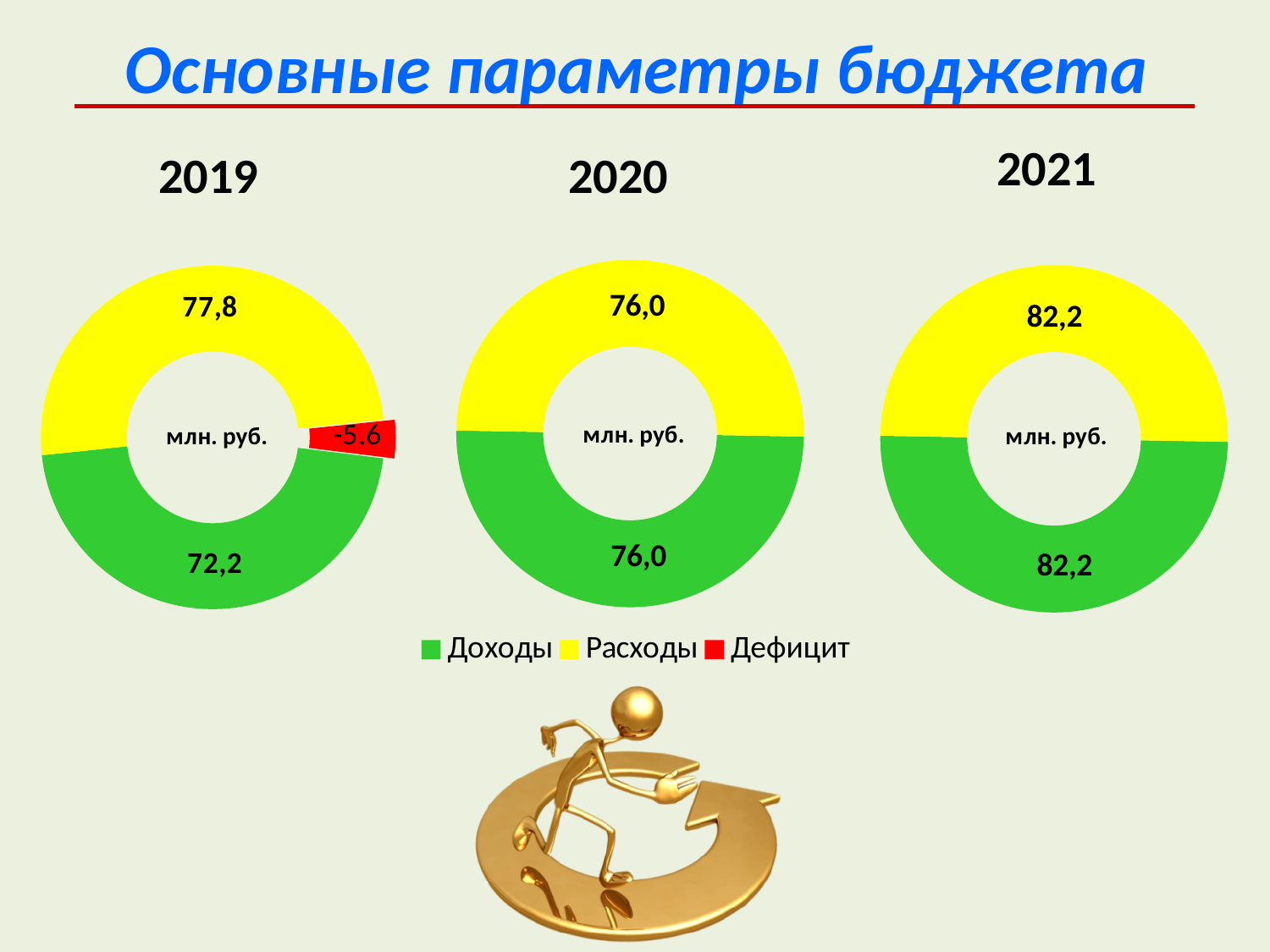
In the 2020 chart, what is the value for Доходы? 76,0 What kind of chart is used for each year on the slide? Doughnut chart Which chart on the slide includes a Дефицит slice? 2019 In the 2019 chart, what is the value for Расходы? 77,8 In the 2019 chart, which is larger, Доходы or Расходы? Расходы What colour represents Доходы in the legend? Green In the 2021 chart, what is the value for Расходы? 82,2 How many doughnut charts are on the slide? 3 In the 2019 chart, what is the value for Доходы? 72,2 In the 2019 chart, what is the value for Дефицит? -5.6 In the 2019 chart, what is the difference between Расходы and Доходы? 5,6 How many series does the legend list? 3